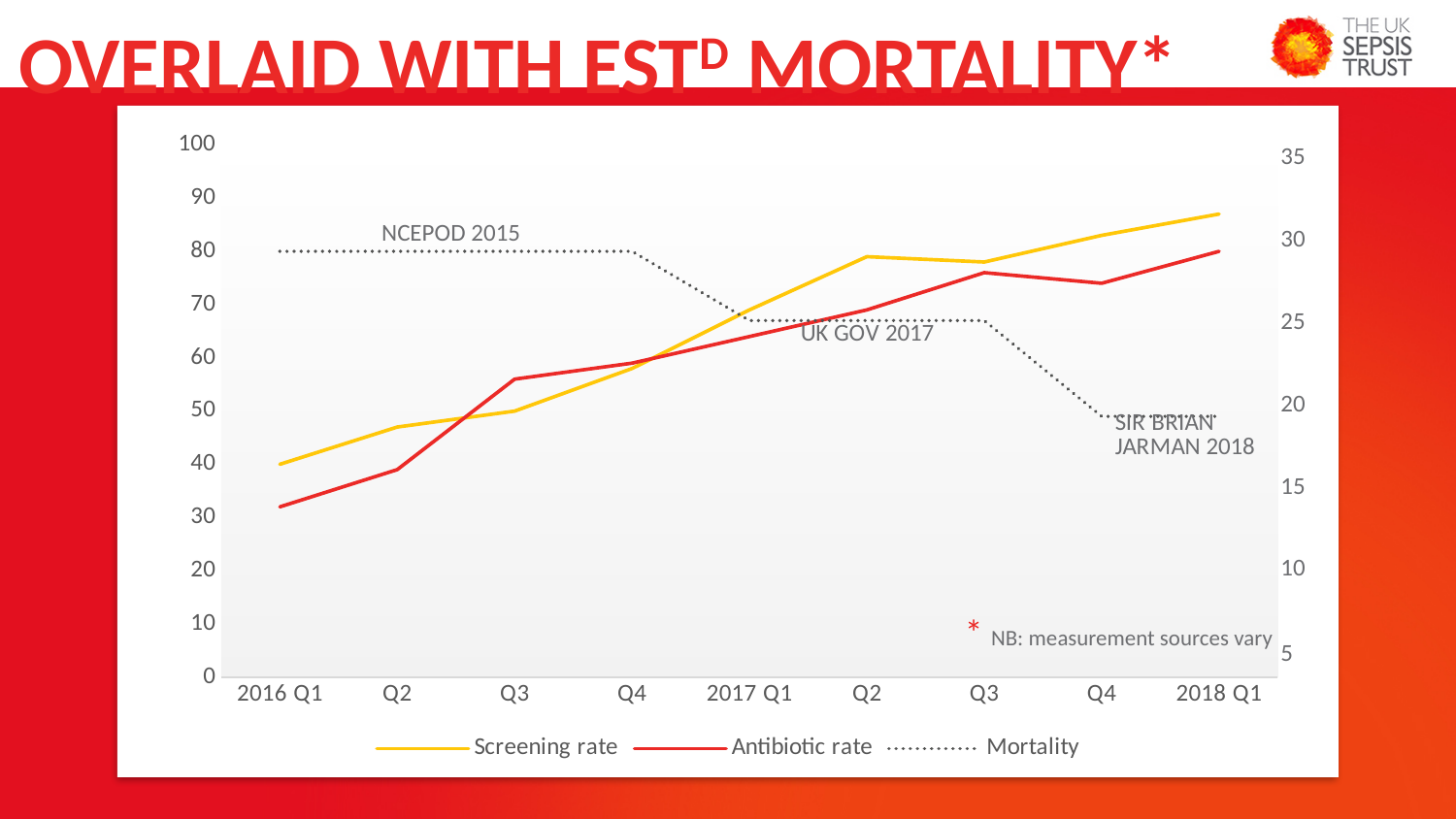
In which quarter is the Screening rate highest? 2018 Q1 Is the Antibiotic rate at 2016 Q1 greater or less than 40? less How many quarters are shown along the x axis of the chart? 9 Does the Screening rate generally rise or fall from 2016 Q1 to 2018 Q1? Rise What kind of chart is shown on the slide? Line chart Is the Screening rate at 2018 Q1 greater or less than 80? greater At 2016 Q3, which is higher: the Screening rate or the Antibiotic rate? Antibiotic rate At 2017 Q2, which is higher: the Screening rate or the Antibiotic rate? Screening rate In which quarter is the Antibiotic rate lowest? 2016 Q1 How many series does the chart legend list? 3 Which series in the legend is drawn as a dotted line? Mortality Does the Mortality line rise or fall across the chart? Fall